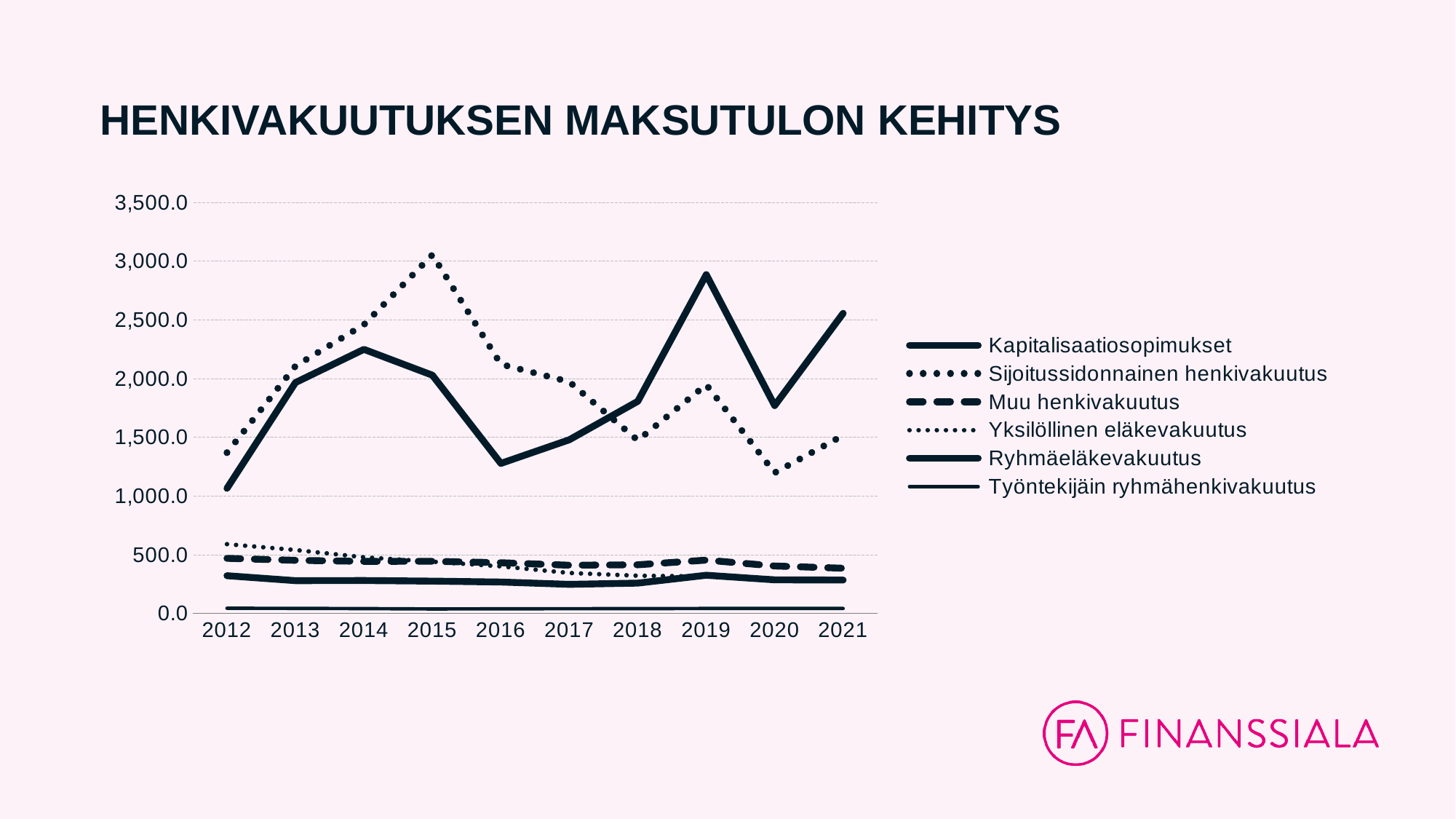
Is the value for Kapitalisaatiosopimukset in 2019 greater or less than 2,500.0? greater In 2021, which is larger: Kapitalisaatiosopimukset or Sijoitussidonnainen henkivakuutus? Kapitalisaatiosopimukset In which year is the Sijoitussidonnainen henkivakuutus series at its lowest? 2020 In which year is the Kapitalisaatiosopimukset series at its lowest? 2012 Does the Yksilöllinen eläkevakuutus series rise or fall from 2012 to 2021? Fall What type of chart is shown on the slide? Line chart What is the title of the chart? HENKIVAKUUTUKSEN MAKSUTULON KEHITYS How many years are shown on the x axis? 10 How many series does the legend list? 6 In which year does the Sijoitussidonnainen henkivakuutus series reach its highest value? 2015 In which year does the Kapitalisaatiosopimukset series reach its highest value? 2019 Is the value for Sijoitussidonnainen henkivakuutus in 2020 greater or less than 1,500.0? less